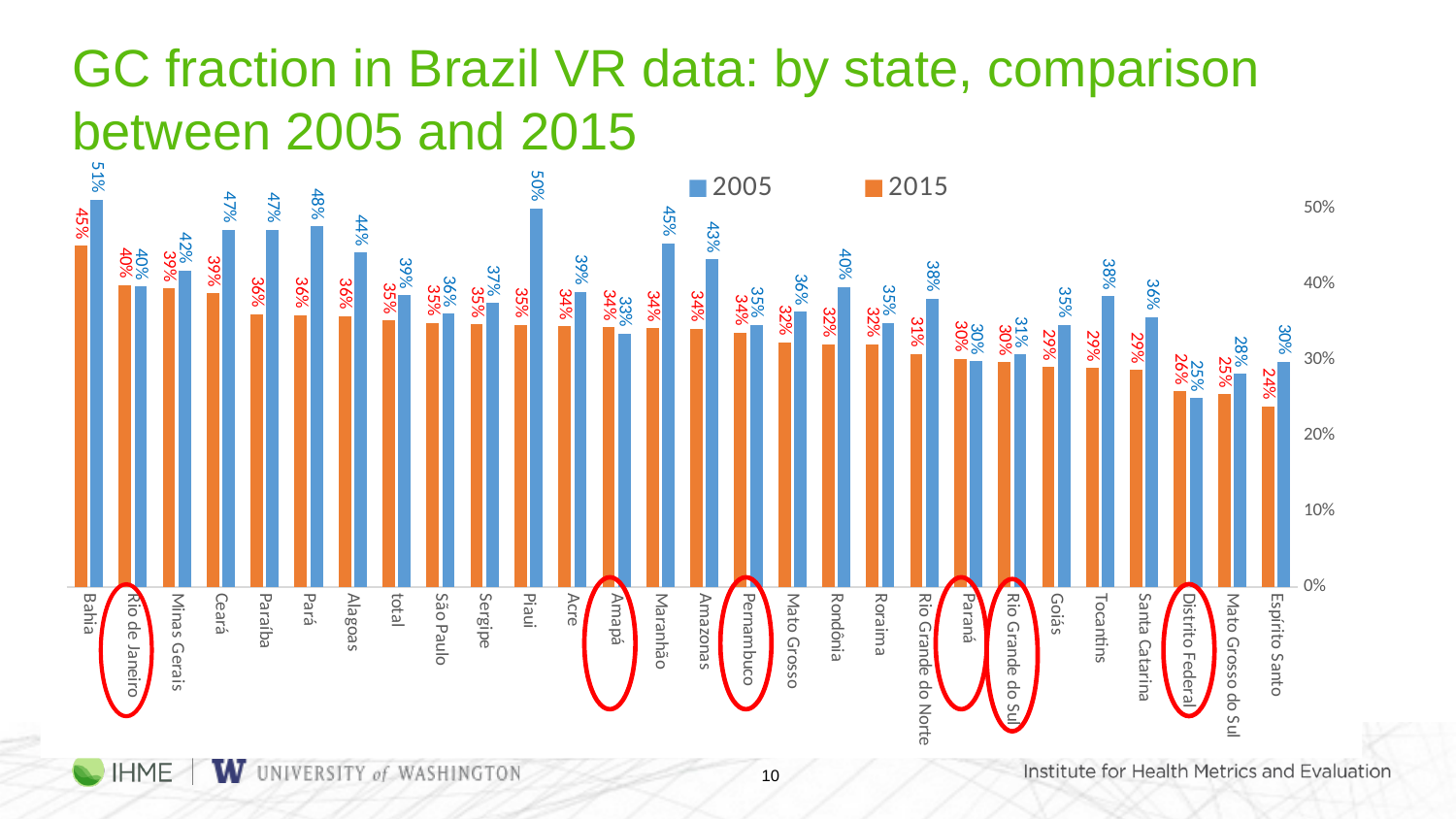
What is the 2015 value for Espírito Santo? 24% Which state has the highest 2005 value? Bahia Which colour represents the 2015 series? Orange Which state has the lowest 2005 value? Distrito Federal Which is larger for Ceará, the 2005 value or the 2015 value? 2005 What is the 2005 value for Pará? 48% What is the 2015 value for Piauí? 35% What is the 2015 value for the 'total' category? 35% How many series does the legend list? 2 What type of chart is shown on the slide? Bar chart What is the 2005 value for Bahia? 51% What is the difference between the 2005 and 2015 values for Piauí? 15%